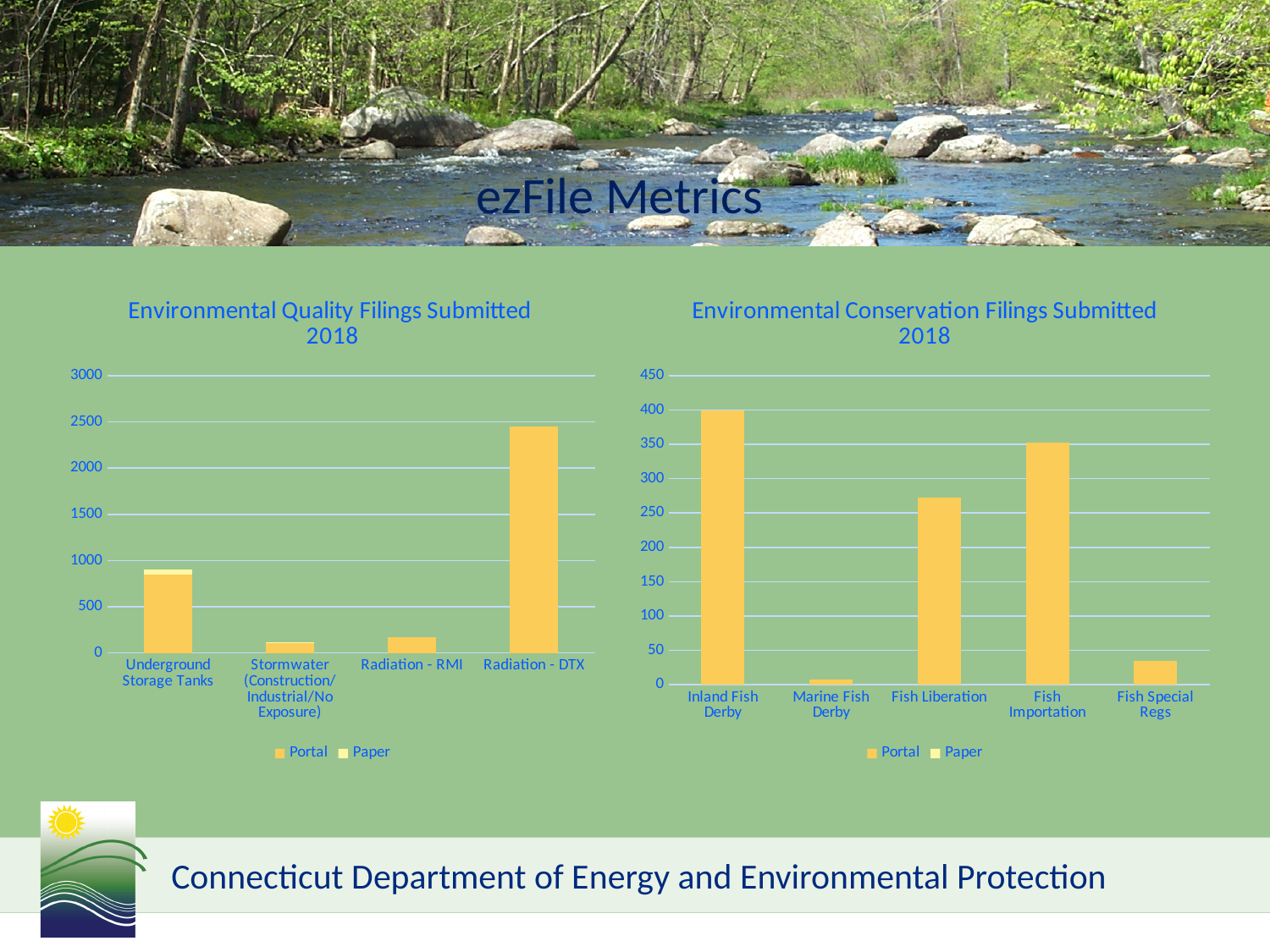
In the Environmental Quality Filings Submitted 2018 chart, which is larger, Radiation - RMI or Underground Storage Tanks? Underground Storage Tanks In the Environmental Quality Filings Submitted 2018 chart, how many series does the legend list? 2 In the Environmental Conservation Filings Submitted 2018 chart, is the value for Fish Special Regs greater or less than 50? less In the Environmental Quality Filings Submitted 2018 chart, how many categories are shown on the x axis? 4 In the Environmental Quality Filings Submitted 2018 chart, is the value for Radiation - DTX greater or less than 2000? greater What kind of chart is the Environmental Conservation Filings Submitted 2018 chart? bar chart In the Environmental Conservation Filings Submitted 2018 chart, is the value for Fish Importation greater or less than 300? greater In the Environmental Conservation Filings Submitted 2018 chart, which category has the lowest value? Marine Fish Derby In the Environmental Conservation Filings Submitted 2018 chart, how many categories are shown on the x axis? 5 In the Environmental Conservation Filings Submitted 2018 chart, which category has the highest value? Inland Fish Derby In the Environmental Quality Filings Submitted 2018 chart, which category has the highest value? Radiation - DTX